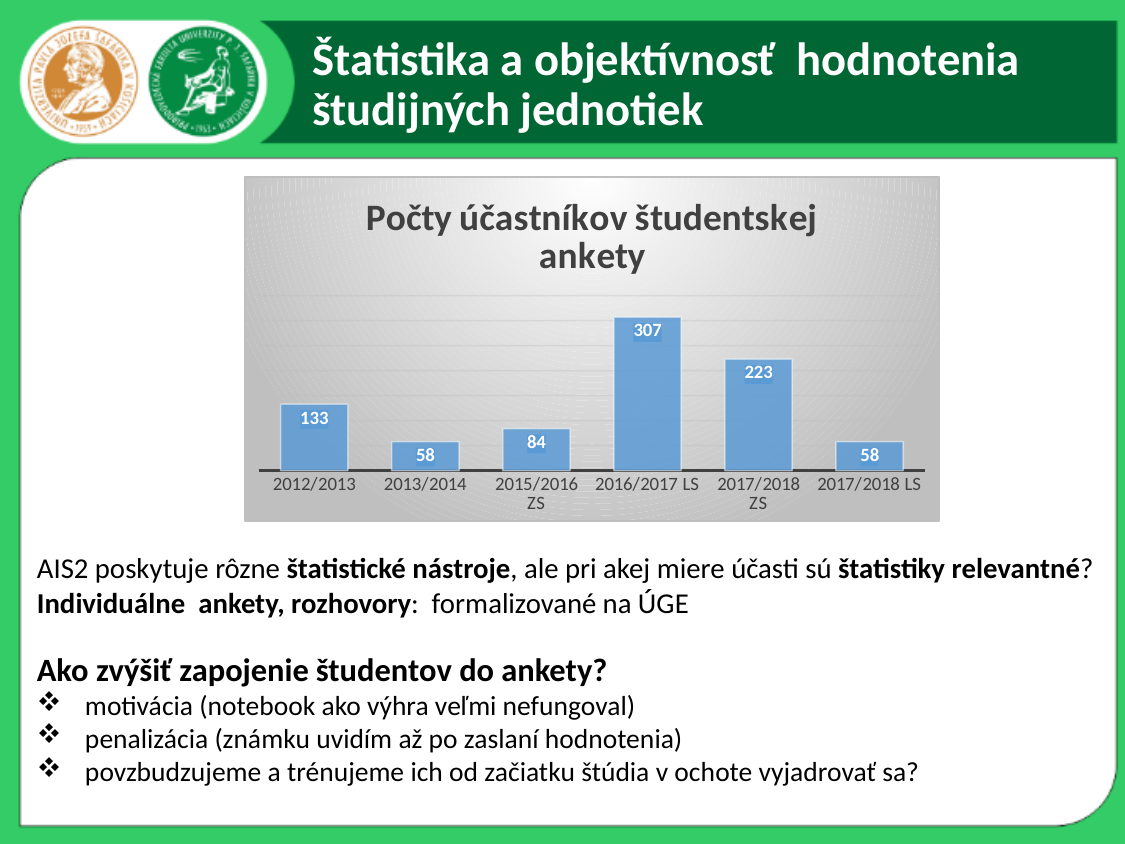
Which category has the highest value? 2016/2017 LS What kind of chart is shown on the slide? bar chart Which is larger, the value for 2017/2018 ZS or the value for 2017/2018 LS? 2017/2018 ZS What is the value for 2017/2018 ZS? 223 What is the difference between the values for 2016/2017 LS and 2017/2018 ZS? 84 What is the title of the chart? Počty účastníkov študentskej ankety What is the value for 2015/2016 ZS? 84 How many categories are shown on the x axis? 6 What is the value for 2016/2017 LS? 307 Which is larger, the value for 2012/2013 or the value for 2015/2016 ZS? 2012/2013 What is the difference between the values for 2012/2013 and 2013/2014? 75 What is the value for 2012/2013? 133